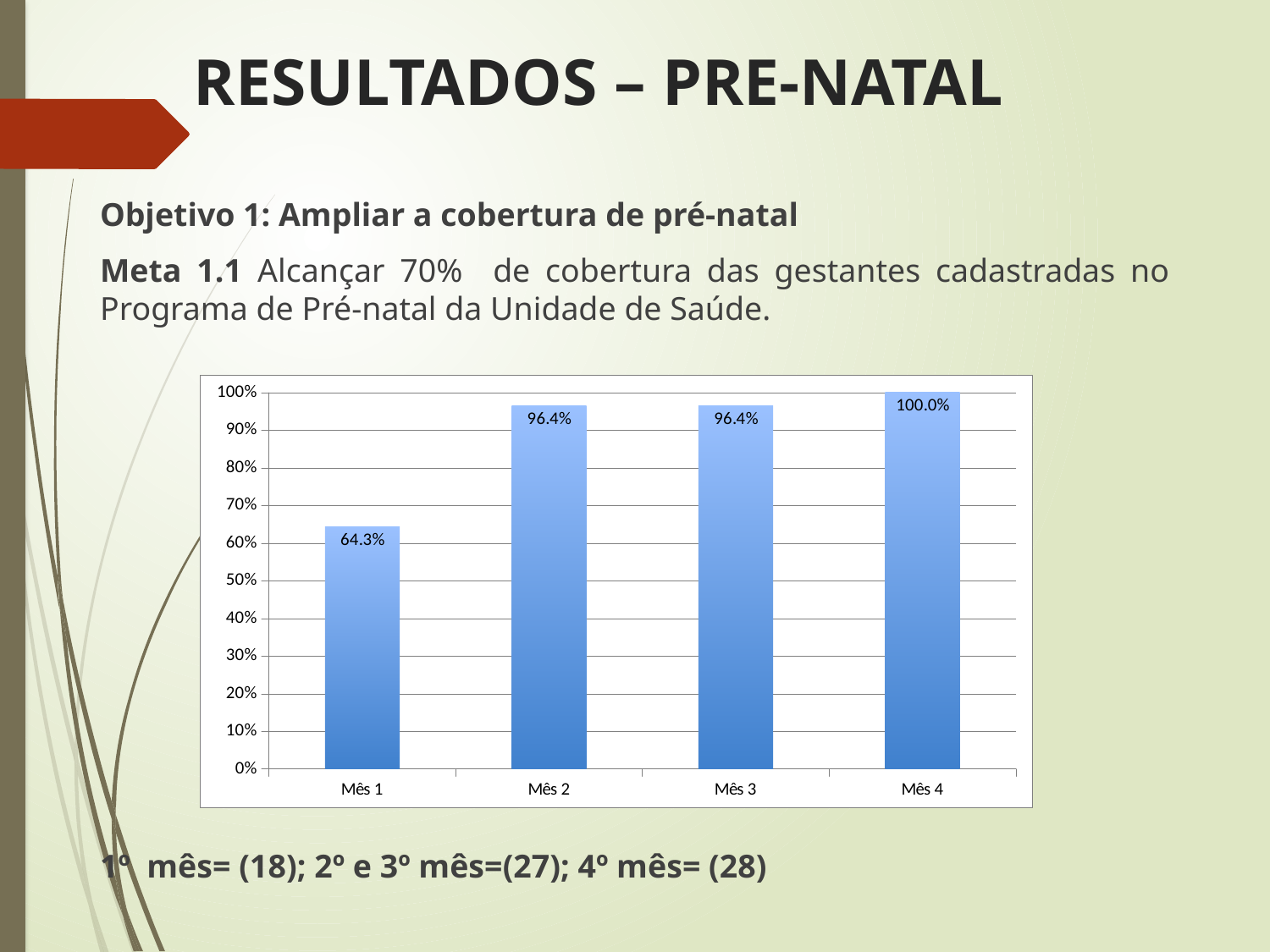
How many months are shown on the x axis? 4 What is the value for Mês 1? 64.3% What kind of chart is shown on the slide? bar chart What is the difference between the values for Mês 4 and Mês 1? 35.7% Which is larger, the value for Mês 1 or the value for Mês 3? Mês 3 Which month has the lowest value? Mês 1 Do the values generally rise or fall from Mês 1 to Mês 4? rise What is the value for Mês 2? 96.4% Is the value for Mês 1 greater or less than 70%? less Which month has the highest value? Mês 4 What is the value for Mês 4? 100.0% What is the difference between the values for Mês 2 and Mês 1? 32.1%